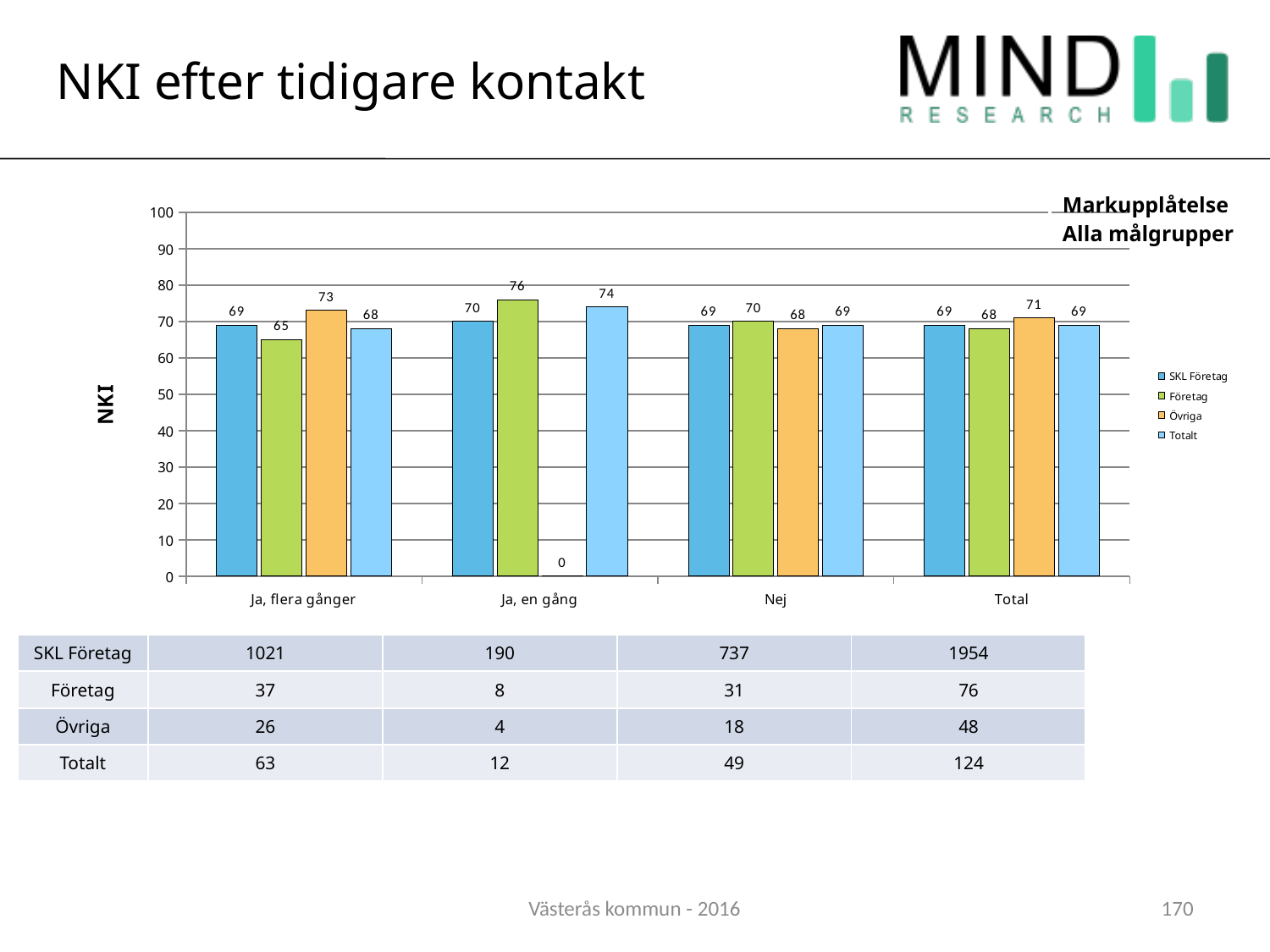
What is the difference between the Företag value and the Övriga value in the 'Ja, en gång' category? 76 How many series does the chart legend list? 4 What is the NKI value for Övriga in the 'Ja, en gång' category? 0 How many categories are shown on the x axis of the chart? 4 Is the NKI value for Övriga in the 'Total' category larger than the value for Företag in the same category? Yes Which series has the highest NKI value in the 'Ja, flera gånger' category? Övriga Which series has the lowest NKI value in the 'Ja, en gång' category? Övriga What is the NKI value for Totalt in the 'Nej' category? 69 What is the NKI value for Företag in the 'Ja, flera gånger' category? 65 What kind of chart is shown on the slide? Bar chart What is the difference between the Övriga value and the Totalt value in the 'Ja, flera gånger' category? 5 What is the label of the y axis of the chart? NKI